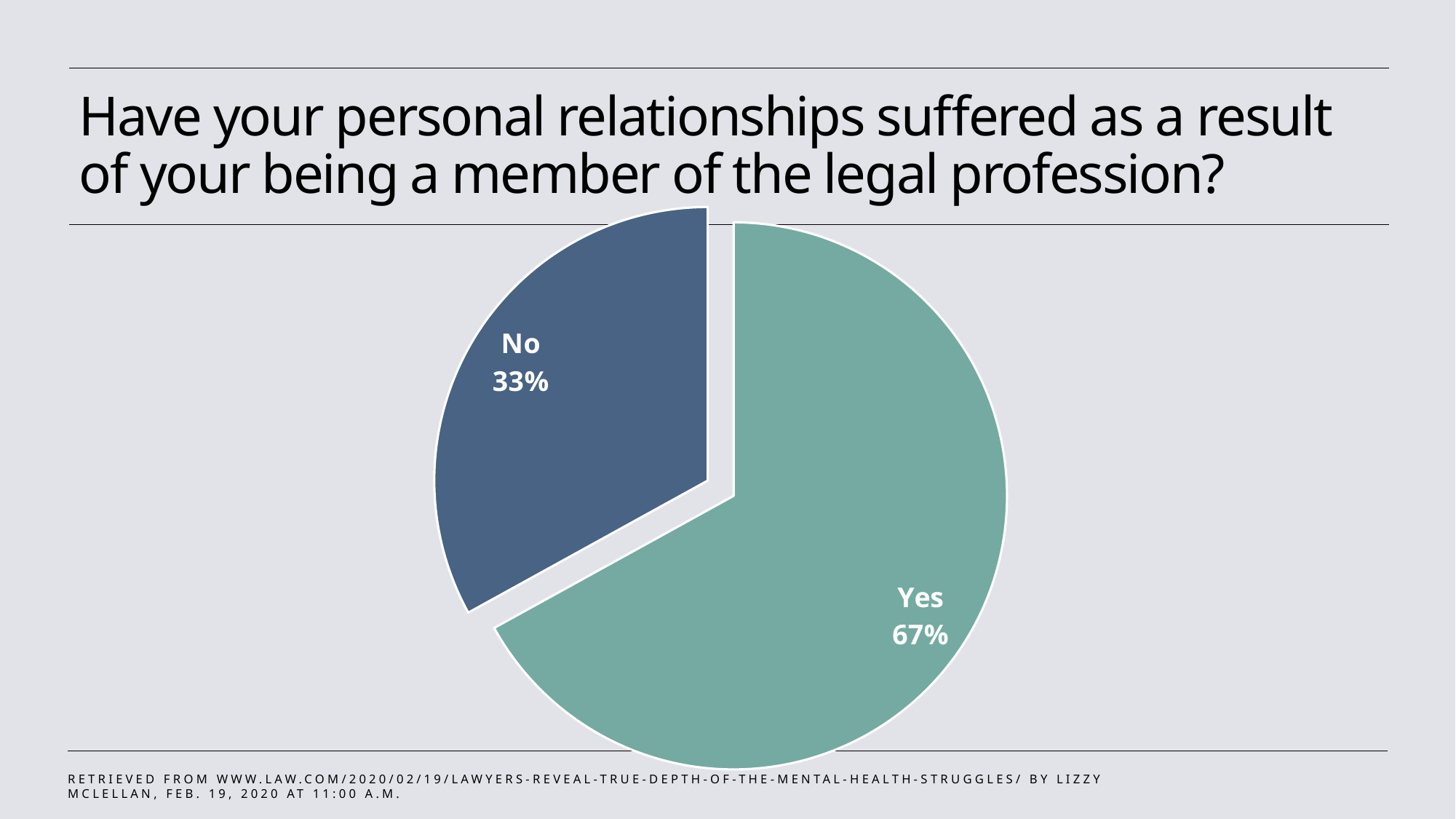
Is the value for Yes greater or less than 50%? greater What colour is the Yes slice? teal green Which slice is pulled out (exploded) from the pie? No What is the difference in percentage points between the Yes and No slices? 34 What percentage of respondents answered Yes? 67% Which response has the largest share of the pie? Yes What percentage of respondents answered No? 33% Which response has the smallest share of the pie? No How many slices does the pie chart have? 2 What share of the pie does the No slice represent? 33% Which slice is larger, Yes or No? Yes What kind of chart is shown on the slide? pie chart